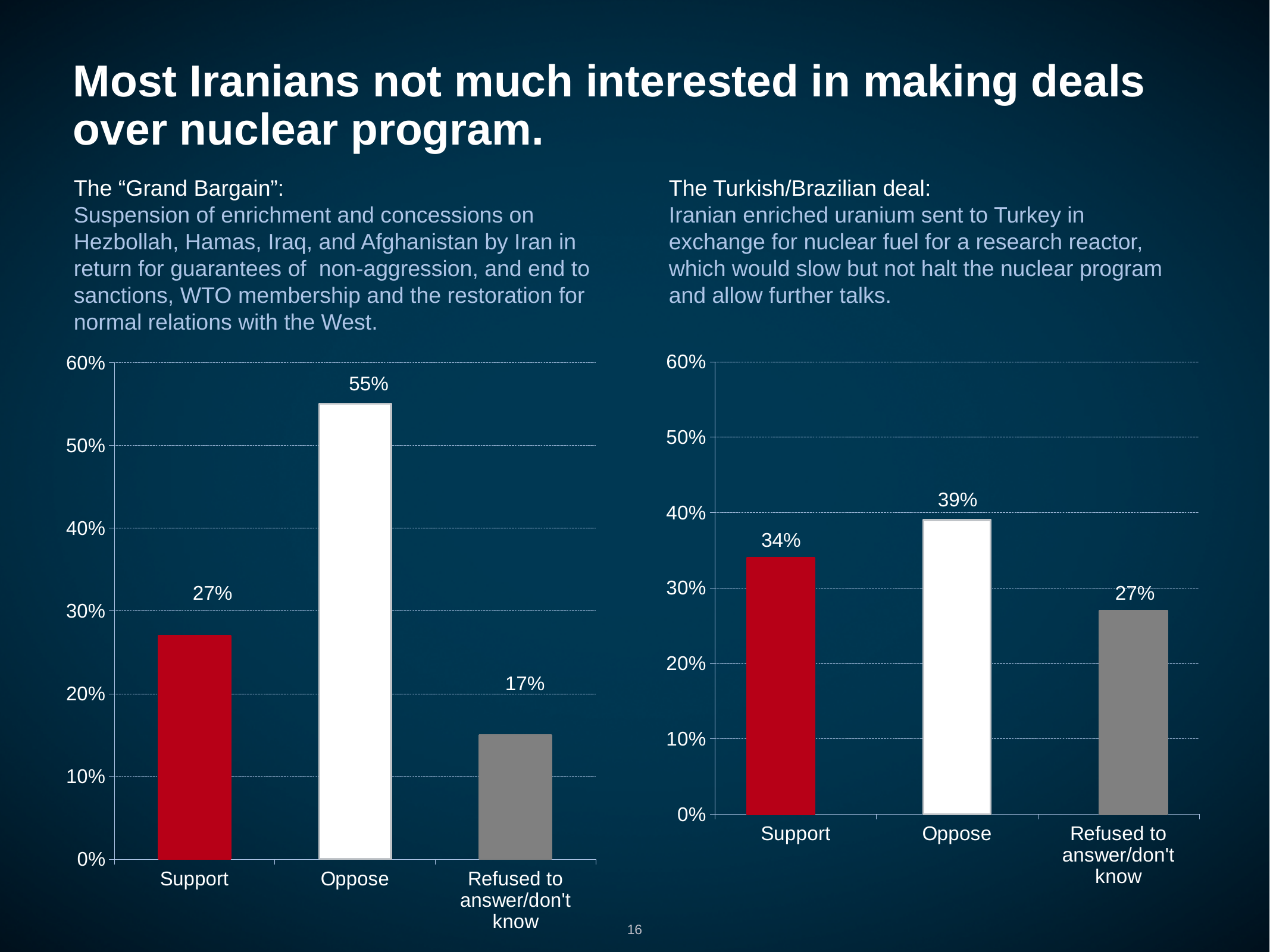
What type of chart is the "Grand Bargain" chart on the left? Bar chart In the "Grand Bargain" chart on the left, is the value for Refused to answer/don't know greater or less than 20%? less In the "Grand Bargain" chart on the left, which category has the highest value? Oppose In the Turkish/Brazilian deal chart on the right, what percentage refused to answer or don't know? 27% Which chart shows a higher Support percentage, the "Grand Bargain" chart on the left or the Turkish/Brazilian deal chart on the right? The Turkish/Brazilian deal chart on the right In the Turkish/Brazilian deal chart on the right, what percentage of respondents support the deal? 34% In the "Grand Bargain" chart on the left, what is the difference between the Oppose and Support percentages? 28% In the Turkish/Brazilian deal chart on the right, what is the difference between the Oppose and Support percentages? 5% In the Turkish/Brazilian deal chart on the right, which category has the lowest value? Refused to answer/don't know In the "Grand Bargain" chart on the left, what percentage of respondents oppose the deal? 55% How many categories are shown in the Turkish/Brazilian deal chart on the right? 3 In the "Grand Bargain" chart on the left, what percentage of respondents support the deal? 27%